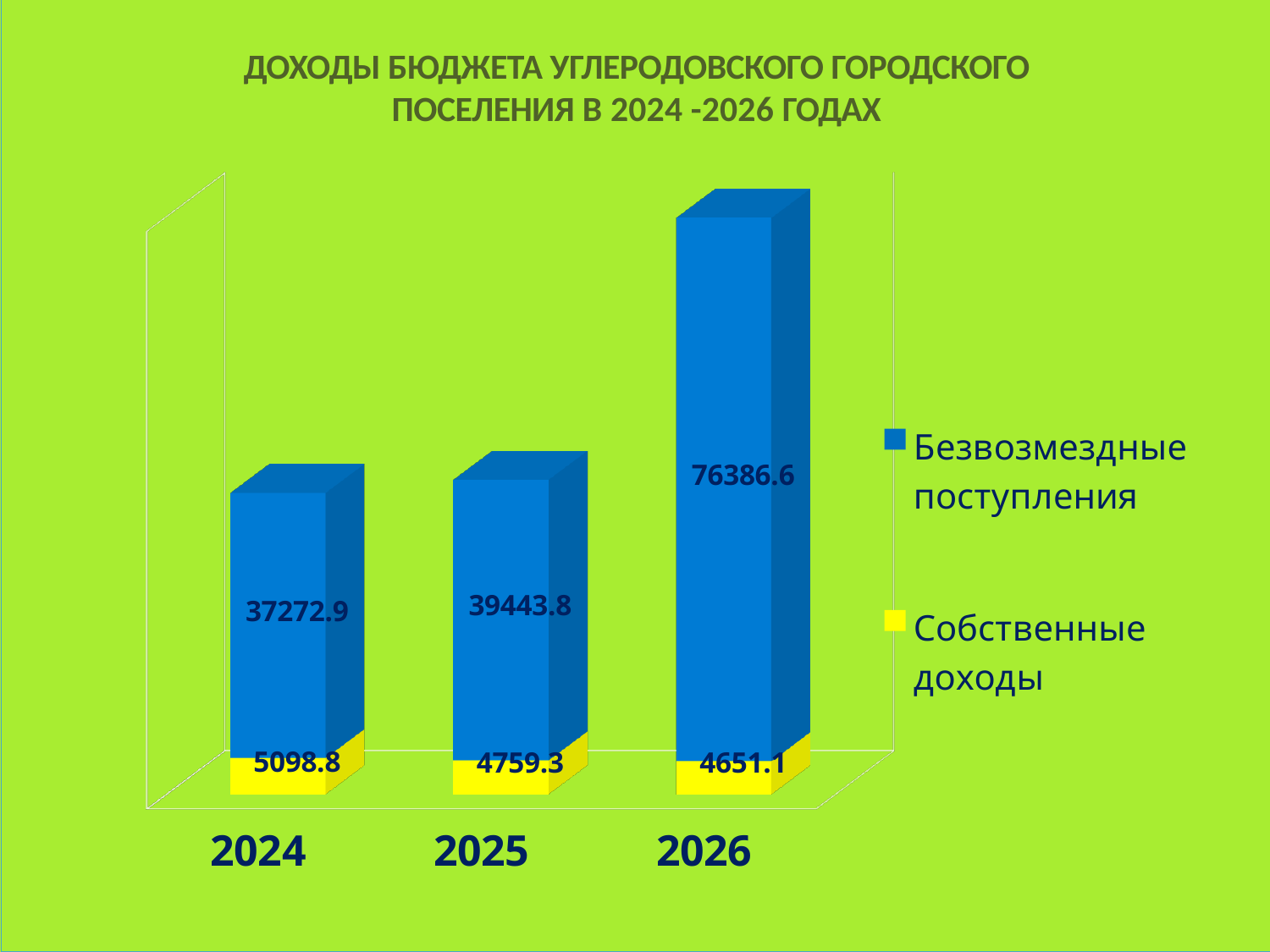
Which year has the highest value of Безвозмездные поступления? 2026 Which year has the lowest value of Собственные доходы? 2026 What is the value of Безвозмездные поступления for 2025? 39443.8 What is the value of Собственные доходы for 2026? 4651.1 How many years are shown on the x axis? 3 How many series does the legend list? 2 What is the value of Безвозмездные поступления for 2024? 37272.9 Which is larger: Собственные доходы in 2024 or in 2025? 2024 What is the total of the stacked bar for 2026? 81037.7 What is the difference between Собственные доходы in 2024 and 2026? 447.7 What is the difference between Безвозмездные поступления in 2026 and 2025? 36942.8 What kind of chart is shown on the slide? Stacked bar chart